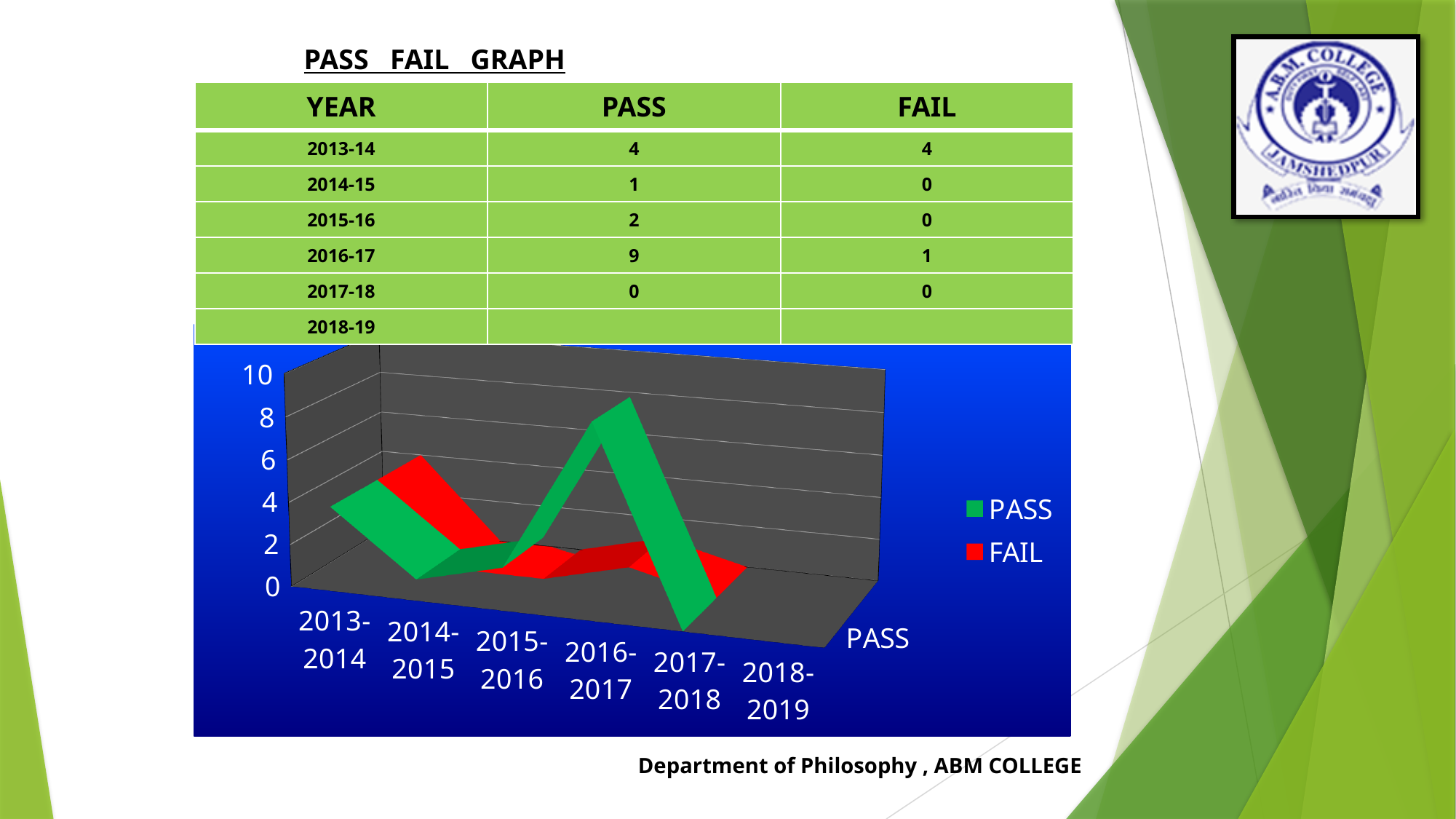
Using the table values, what is the difference between PASS and FAIL in 2016-17? 8 Does the PASS series rise or fall from 2016-2017 to 2017-2018? fall According to the table above the chart, what is the FAIL value for 2013-14? 4 In which year does the PASS series reach its highest value? 2016-2017 Is the PASS value for 2016-2017 greater or less than 8? greater How many series does the chart legend list? 2 According to the table above the chart, what is the PASS value for 2016-17? 9 Is the PASS value for 2013-2014 greater or less than 6? less Which two series are listed in the chart legend? PASS and FAIL How many year categories are shown along the x axis of the chart? 6 Which is larger in 2016-2017, the PASS value or the FAIL value? PASS What kind of chart is shown on the slide? 3D line chart